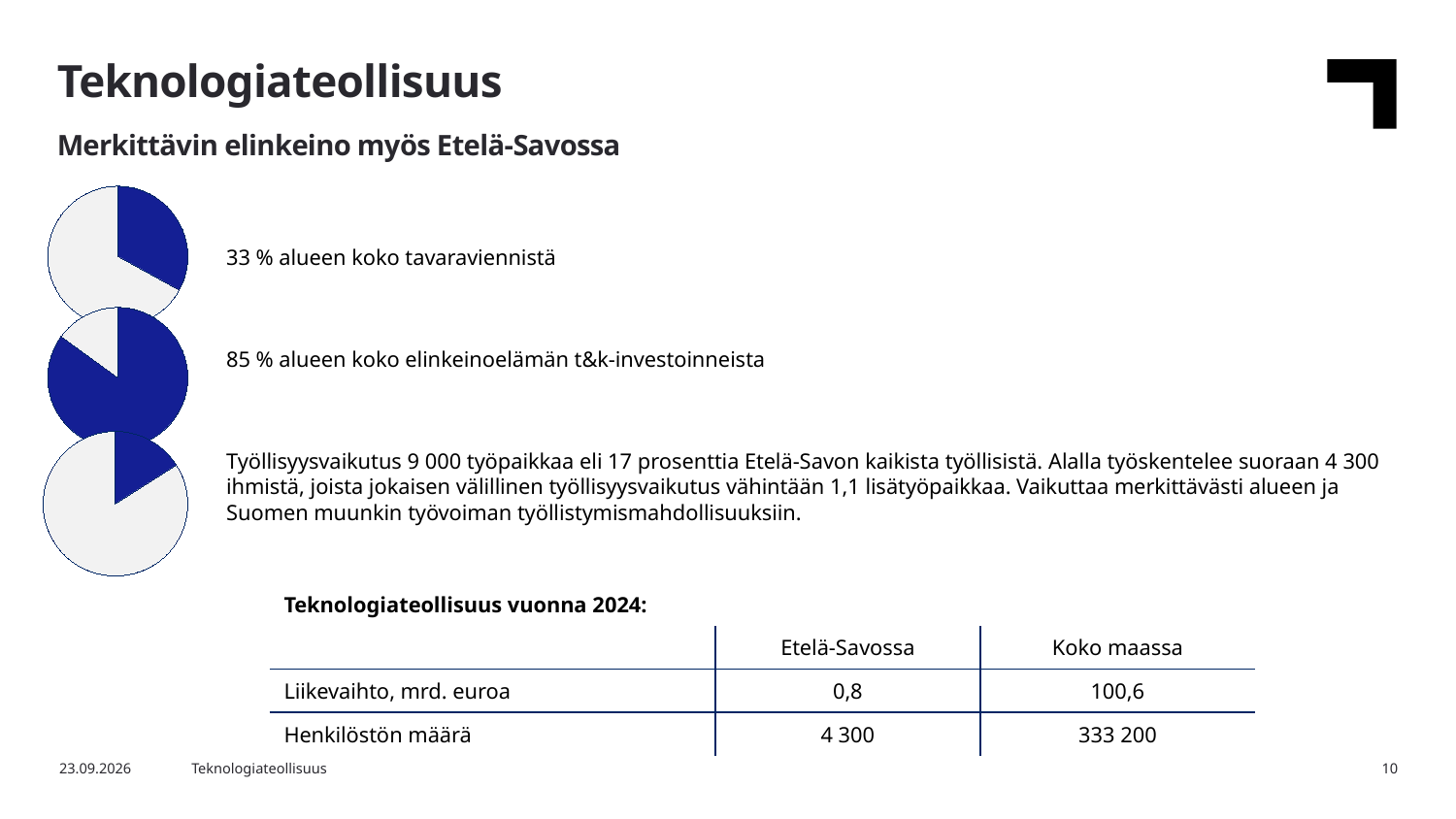
In the bottom pie chart (työllisyysvaikutus), what share of Etelä-Savo's employed does the blue slice represent? 17 prosenttia Is the blue slice larger in the top pie chart or in the bottom pie chart? Top pie chart Which of the three pie charts has the largest blue slice? The middle one (85 % of t&k-investoinnit) What kind of charts are shown on the left side of the slide? Pie charts What colour is the highlighted slice in each pie chart? Blue In the top pie chart (tavaravienti), what share does the blue slice represent? 33 % How many pie charts are on the slide? 3 Which of the three pie charts has the smallest blue slice? The bottom one (17 % of työlliset) What is the difference in percentage points between the blue share of the middle pie chart and the top pie chart? 52 percentage points What does the top pie chart's blue slice represent? Share of the region's total goods exports (alueen koko tavaravienti) In the middle pie chart (t&k-investoinnit), what share does the blue slice represent? 85 % Is the blue share in the middle pie chart greater or less than 50 %? Greater